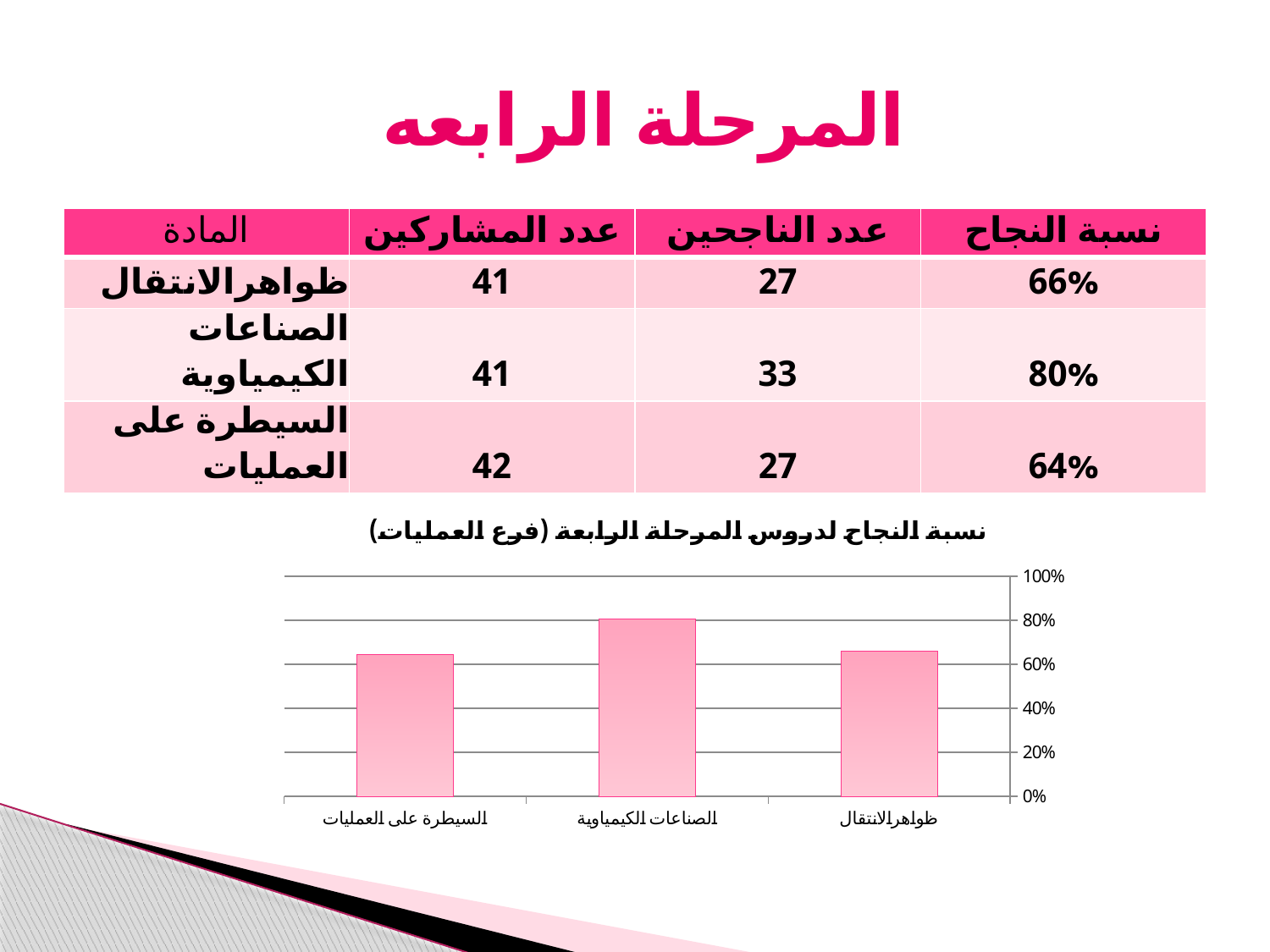
What is the title of the bar chart? نسبة النجاح لدروس المرحلة الرابعة (فرع العمليات) How many categories are plotted in the bar chart? 3 Is the value for ظواهر الانتقال in the chart greater or less than 80%? less What kind of chart is shown on the slide? bar chart Is the value for الصناعات الكيمياوية in the chart greater or less than 60%? greater According to the slide, what is the success rate (نسبة النجاح) for ظواهر الانتقال? 66% According to the slide, what is the success rate (نسبة النجاح) for الصناعات الكيمياوية? 80% What is the difference between the success rate for الصناعات الكيمياوية and the success rate for ظواهر الانتقال shown on the slide? 14% Which is larger in the chart, the value for الصناعات الكيمياوية or the value for ظواهر الانتقال? الصناعات الكيمياوية Is the value for السيطرة على العمليات in the chart greater or less than 40%? greater Which category has the highest bar in the chart? الصناعات الكيمياوية According to the slide, what is the success rate (نسبة النجاح) for السيطرة على العمليات? 64%